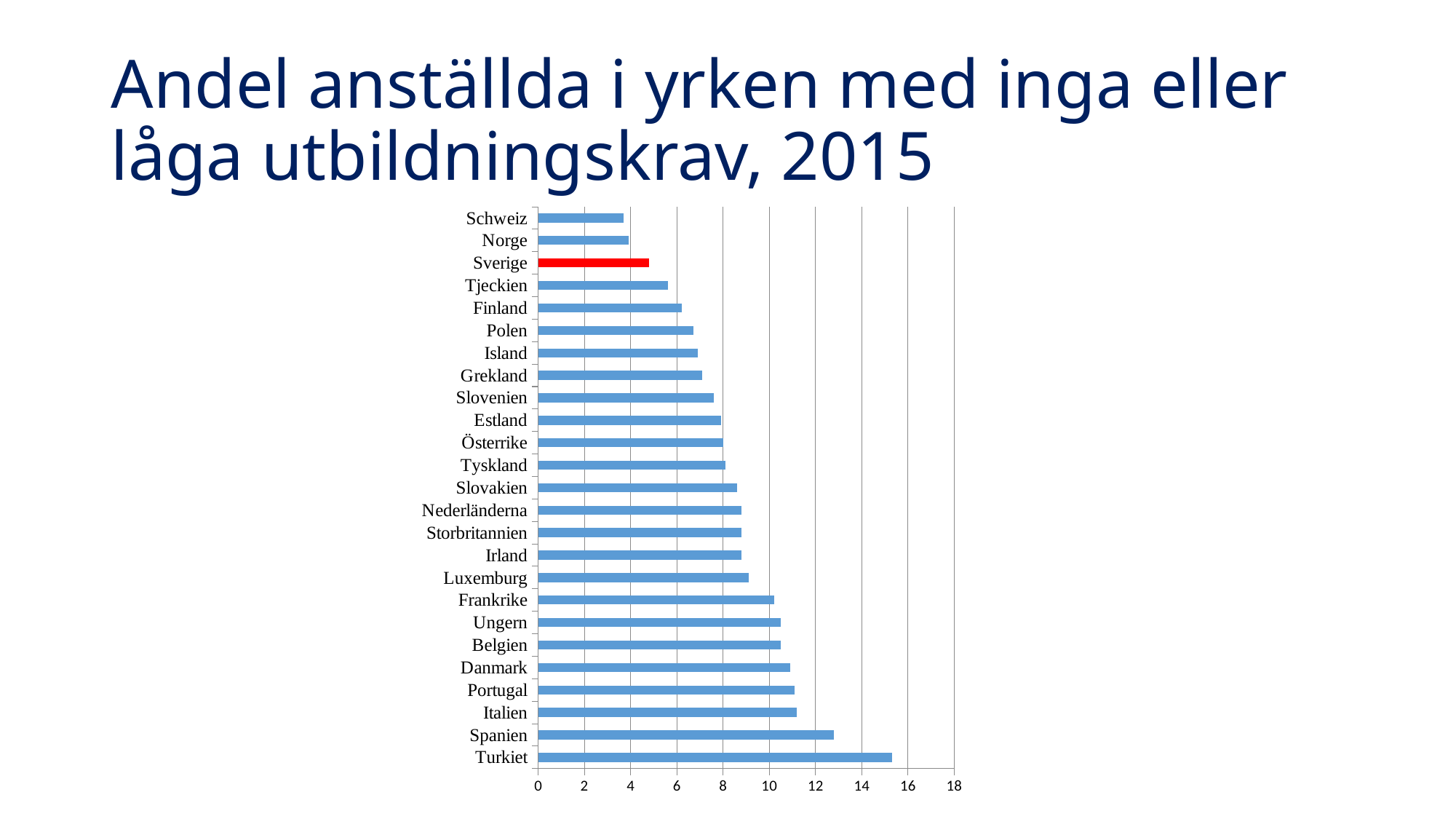
Which has the larger value, Sverige or Norge? Sverige Is the value for Schweiz greater or less than 4? less Is the value for Luxemburg greater or less than 8? greater Is the value for Turkiet greater or less than 14? greater Which has the larger value, Danmark or Finland? Danmark How many countries are shown in the chart? 25 Which country's bar is coloured red in the chart? Sverige Which country has the highest value in the chart? Turkiet What kind of chart is shown on the slide? bar chart